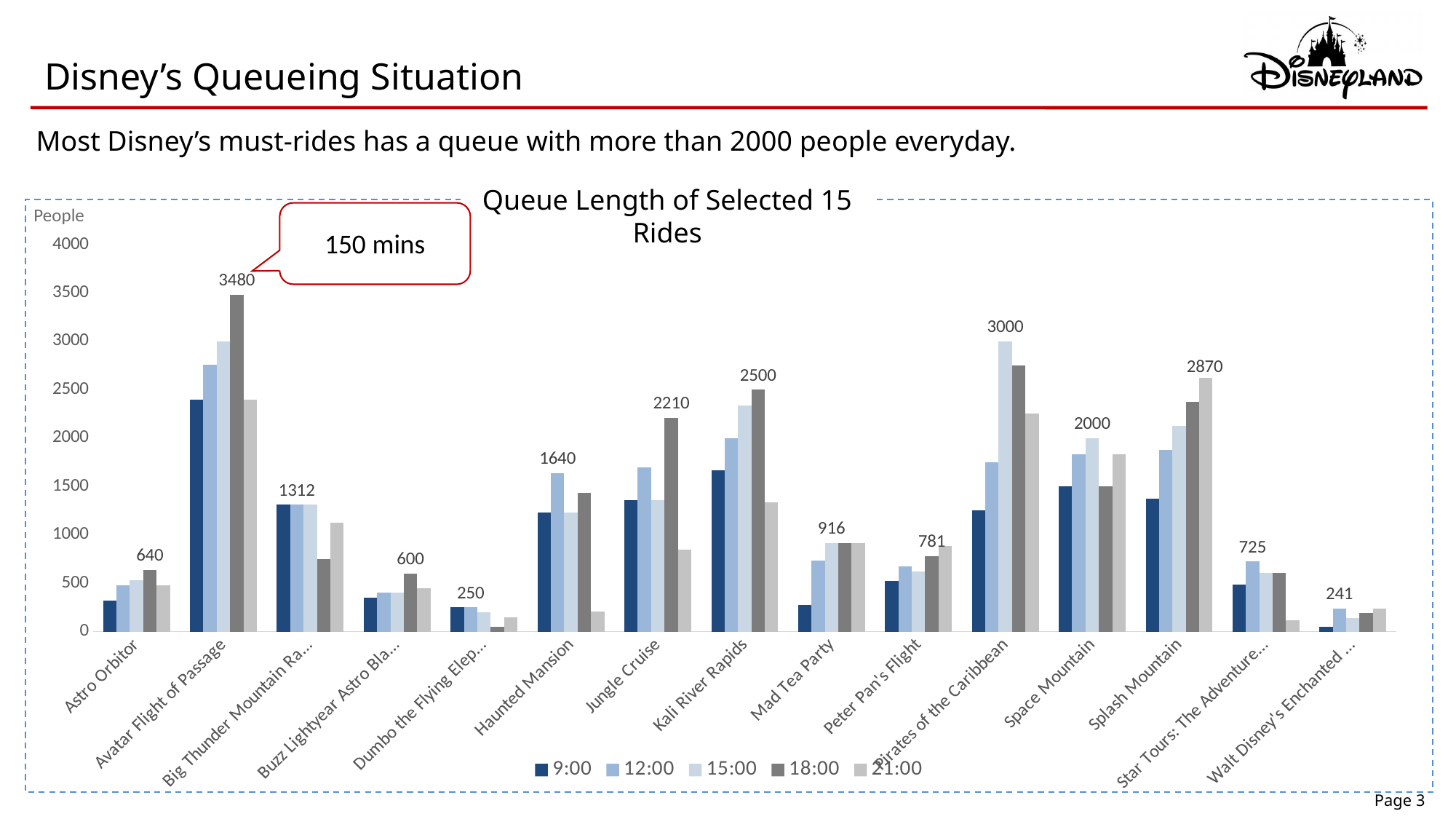
How many series does the legend of the 'Queue Length of Selected 15 Rides' chart list? 5 What is the queue length for Splash Mountain at 21:00? 2870 Is the 9:00 queue length for Avatar Flight of Passage greater or less than 2000? greater What waiting time does the callout next to the Avatar Flight of Passage bar state? 150 mins What is the queue length for Avatar Flight of Passage at 18:00? 3480 What is the queue length for Pirates of the Caribbean at 15:00? 3000 What type of chart is shown on the slide? bar chart What is the queue length for Kali River Rapids at 18:00? 2500 Which ride has the highest queue length shown in the chart? Avatar Flight of Passage Which is larger: the 18:00 queue for Jungle Cruise or the 12:00 queue for Haunted Mansion? Jungle Cruise at 18:00 What is the difference between the 18:00 queue for Avatar Flight of Passage and the 15:00 queue for Pirates of the Caribbean? 480 How many rides are shown on the x axis of the chart? 15